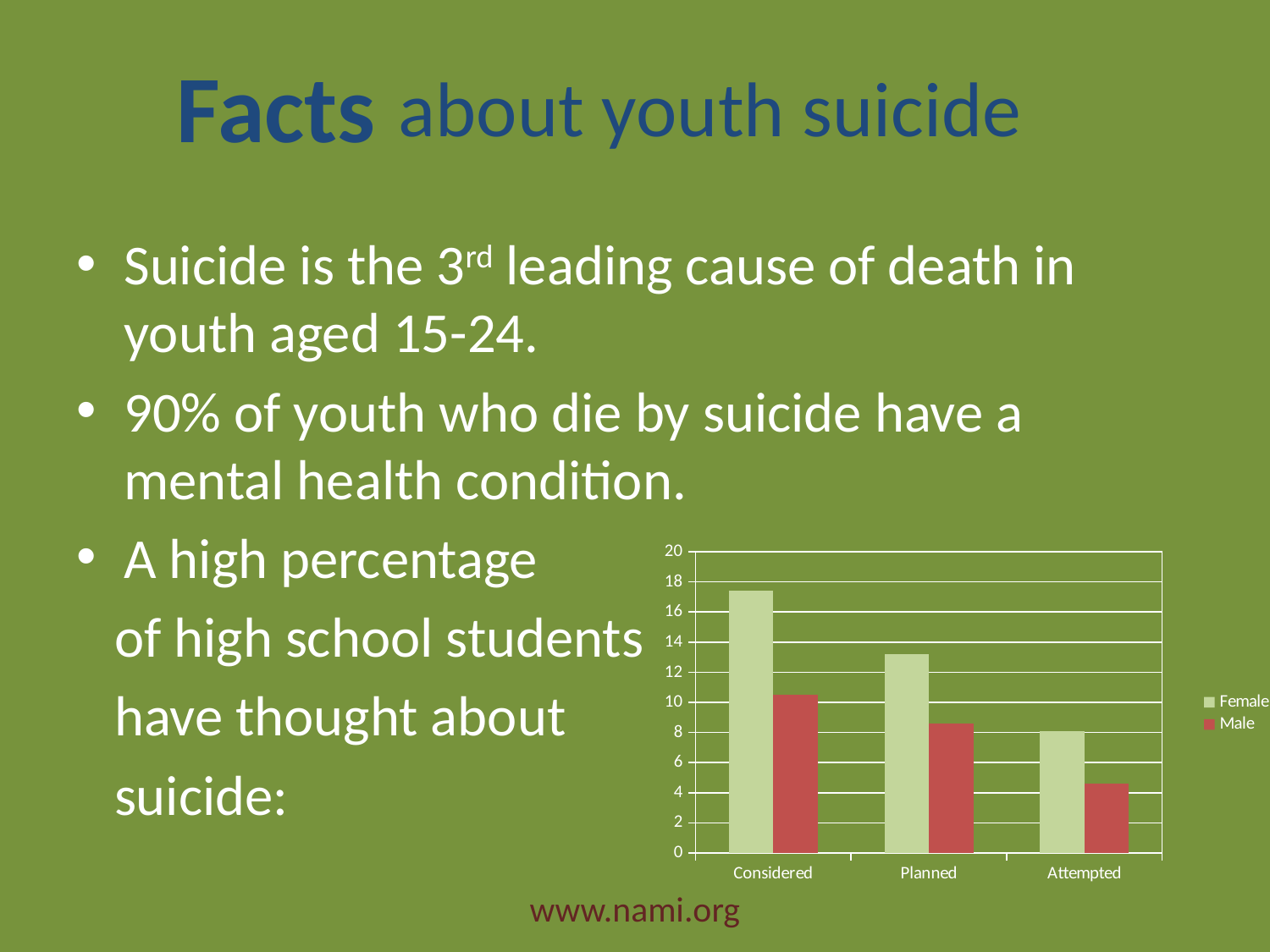
Which is larger for the Planned category, the Female value or the Male value? Female Is the Female value for Considered greater or less than 16? greater How many categories are shown on the x axis of the chart? 3 Which category has the highest Female value? Considered Which series is shown in red in the chart? Male Is the Male value for Considered greater or less than 12? less What is the highest value shown on the chart's vertical axis? 20 Is the Male value for Attempted greater or less than 6? less How many series does the chart's legend list? 2 Which category has the lowest Male value? Attempted Do the Female values rise or fall from Considered to Attempted? fall What kind of chart is shown on the slide? bar chart